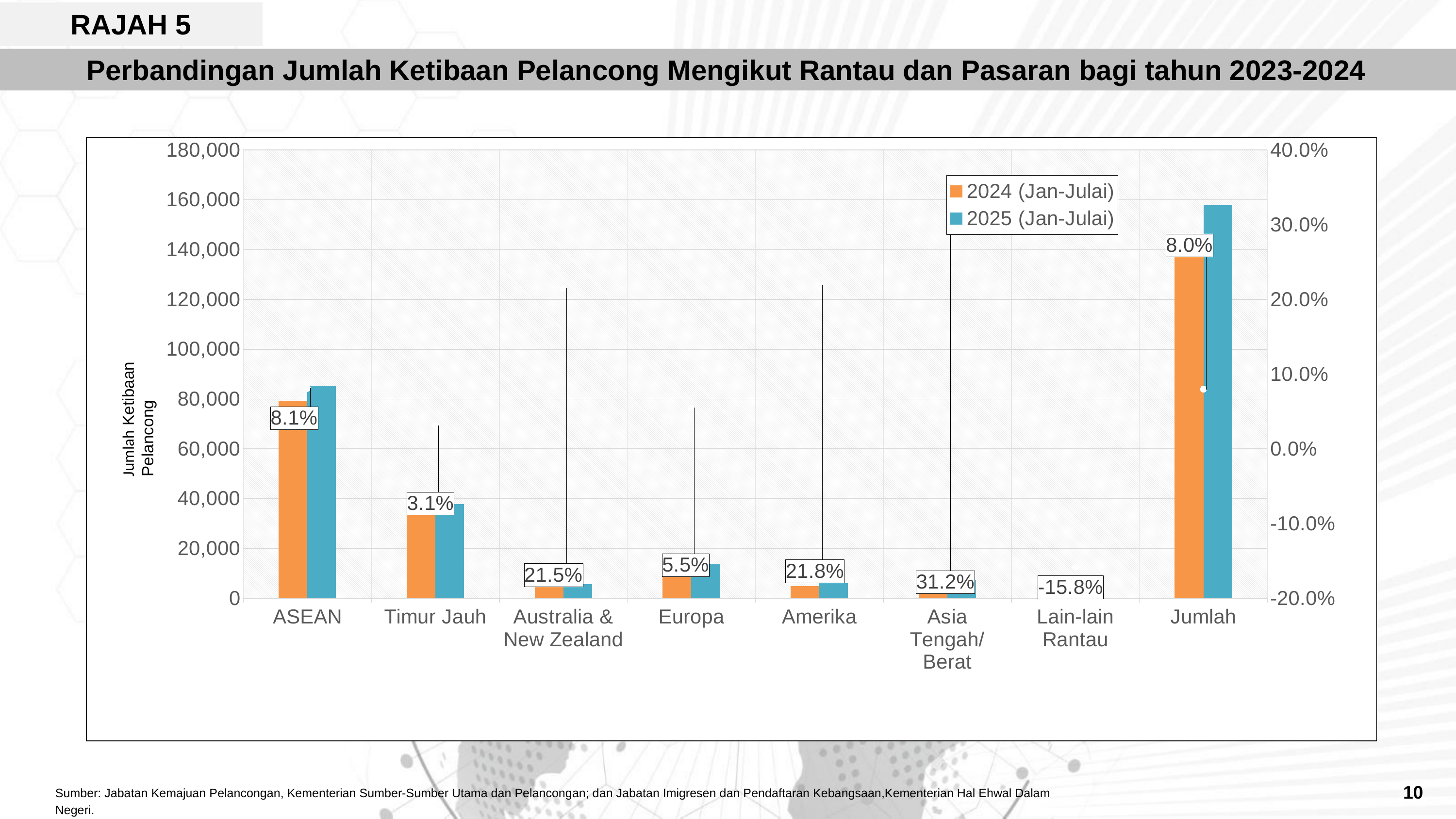
What is the difference between the percentage change labels for Amerika and Australia & New Zealand? 0.3% How many categories are shown on the x axis? 8 Is the 2024 (Jan-Julai) value for Timur Jauh greater or less than 40,000? less Which category has the highest percentage change label? Asia Tengah/Barat Which has a larger percentage change label, Europa or Amerika? Amerika What percentage change is shown for Jumlah? 8.0% Which category has the lowest percentage change label? Lain-lain Rantau How many series does the legend list? 2 What percentage change is shown for Asia Tengah/Barat? 31.2% What percentage change is shown for ASEAN? 8.1% What percentage change is shown for Lain-lain Rantau? -15.8% Is the 2025 (Jan-Julai) value for Jumlah greater or less than 140,000? greater